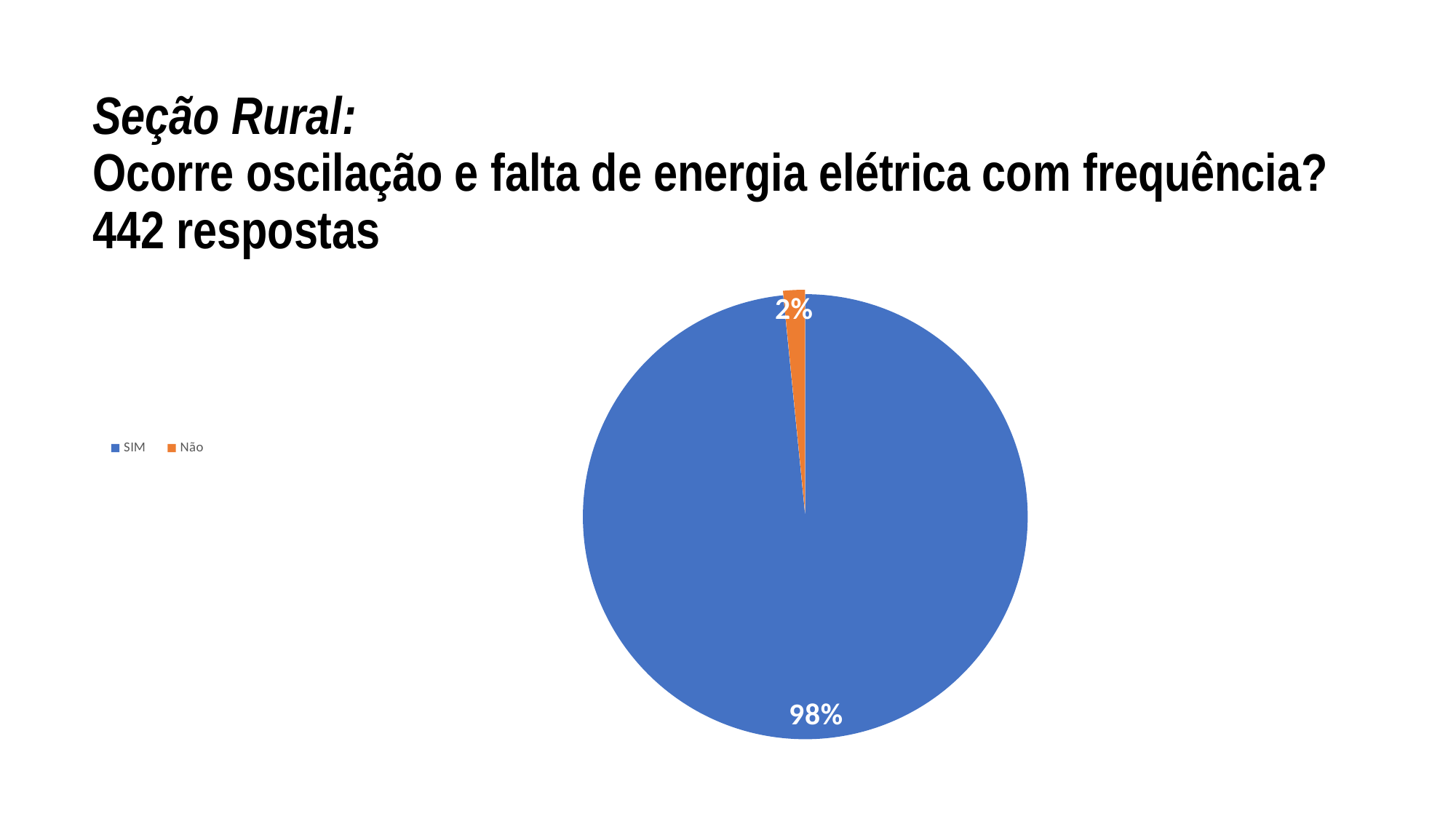
Which category has the smallest slice of the pie? Não Which category has the largest slice of the pie? SIM How many entries does the legend list? 2 Which slice is larger, SIM or Não? SIM How many categories does the pie chart show? 2 How many responses does the slide say the chart is based on? 442 What is the difference in percentage points between the SIM and Não slices? 96 What share of the pie does Não represent? 2% What share of the pie does SIM represent? 98% What colour is the SIM slice? blue What kind of chart is shown on the slide? pie chart